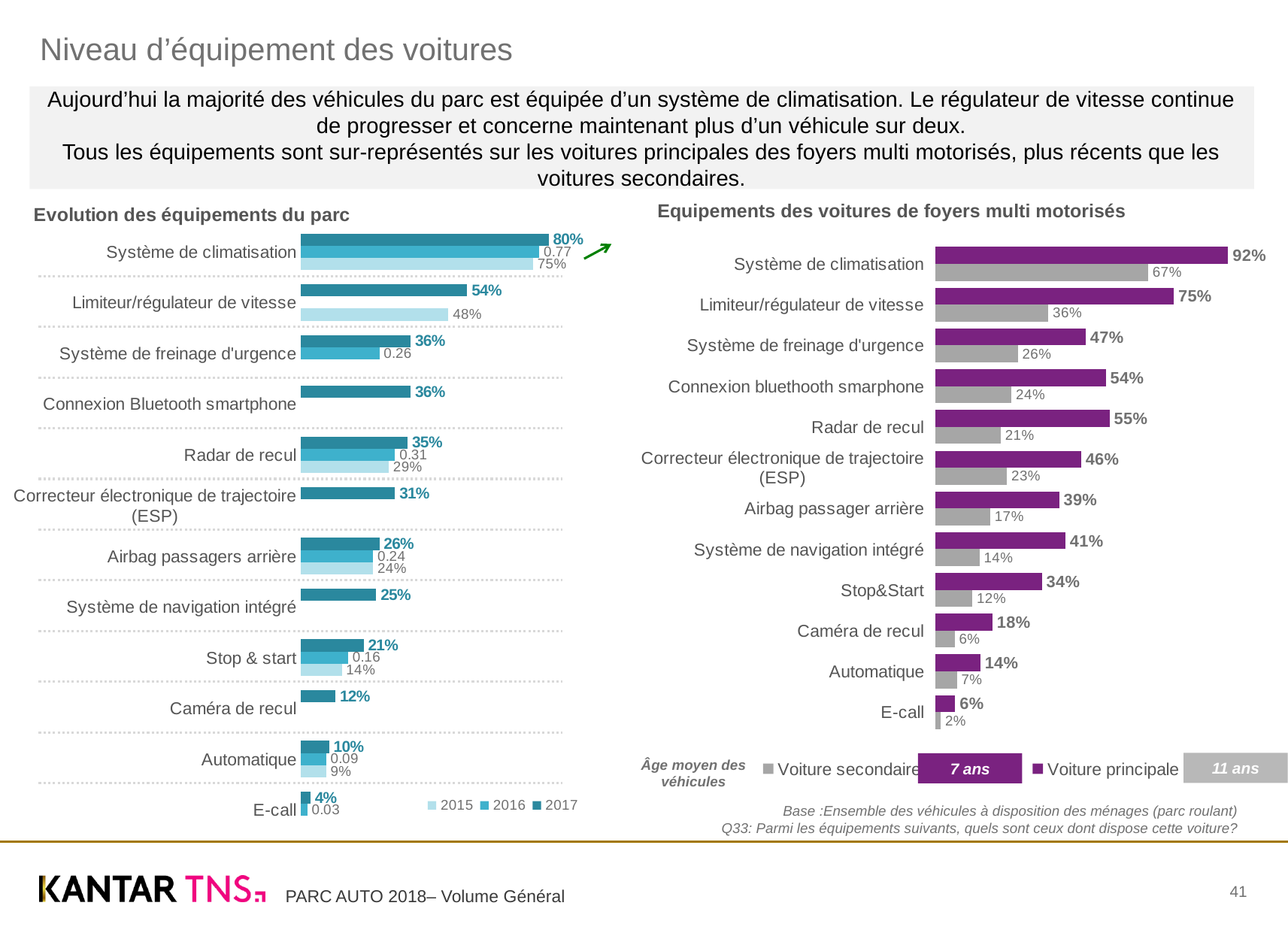
In the chart 'Evolution des équipements du parc', how many series does the legend list? 3 In the chart 'Equipements des voitures de foyers multi motorisés', which equipment has the highest Voiture principale value? Système de climatisation In the chart 'Evolution des équipements du parc', which equipment has the lowest 2017 value? E-call How many equipment categories are shown in the chart 'Equipements des voitures de foyers multi motorisés'? 12 In the chart 'Equipements des voitures de foyers multi motorisés', what is the difference between Voiture principale and Voiture secondaire for Limiteur/régulateur de vitesse? 39% In the chart 'Equipements des voitures de foyers multi motorisés', what is the Voiture secondaire value for Système de navigation intégré? 14% In the chart 'Equipements des voitures de foyers multi motorisés', which is larger for Connexion bluethooth smarphone: Voiture principale or Voiture secondaire? Voiture principale In the chart 'Evolution des équipements du parc', what is the 2015 value for Limiteur/régulateur de vitesse? 48% What type of chart is 'Equipements des voitures de foyers multi motorisés'? Bar chart In the chart 'Evolution des équipements du parc', what is the 2017 value for Système de climatisation? 80% In the chart 'Evolution des équipements du parc', what is the difference between the 2017 and 2015 values for Stop & start? 7% In the chart 'Equipements des voitures de foyers multi motorisés', what is the Voiture principale value for Radar de recul? 55%